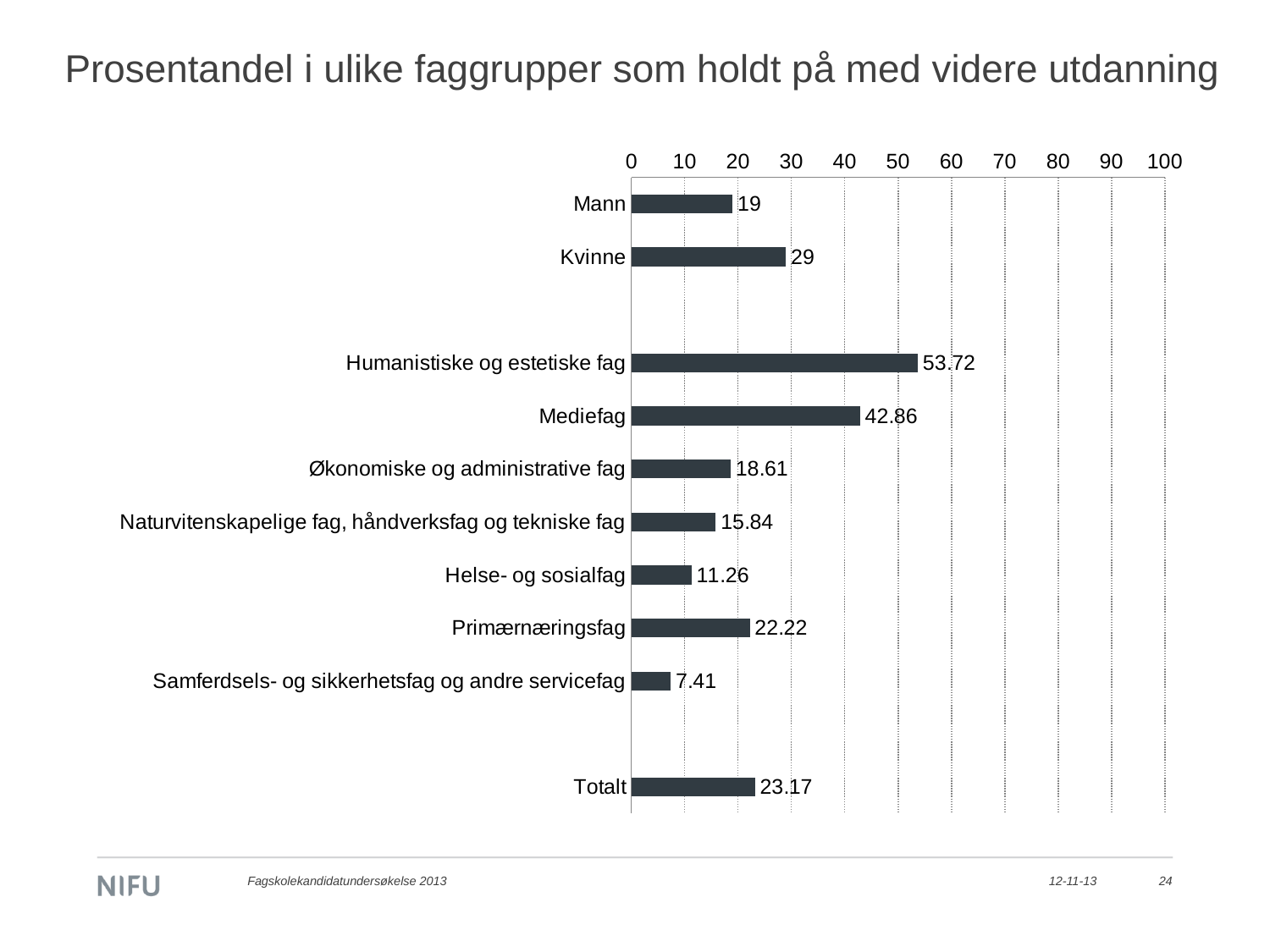
What is the value for Helse- og sosialfag? 11.26 What is the value for Humanistiske og estetiske fag? 53.72 What is the difference between the values for Humanistiske og estetiske fag and Mediefag? 10.86 Which category has the lowest value? Samferdsels- og sikkerhetsfag og andre servicefag What is the value for Mann? 19 What is the value for Totalt? 23.17 What kind of chart is shown on the slide? bar chart How many bars are plotted in the chart? 10 Is the value for Mediefag greater or less than 40? greater Which category has the highest value? Humanistiske og estetiske fag What is the difference between the values for Kvinne and Mann? 10 Which is larger, the value for Primærnæringsfag or the value for Økonomiske og administrative fag? Primærnæringsfag